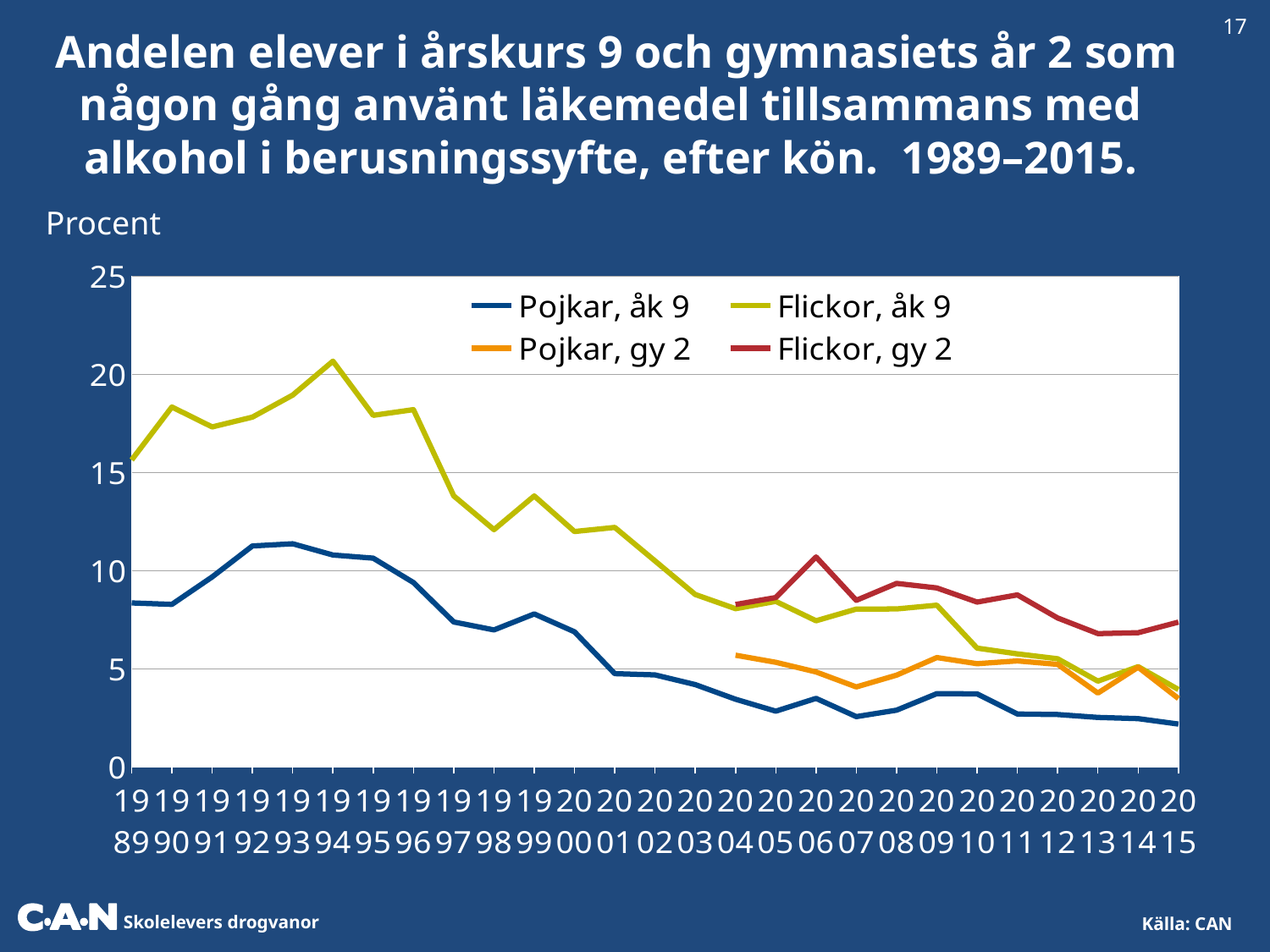
Which series has the highest value in 2015? Flickor, gy 2 Is the value for Pojkar, åk 9 in 2015 greater or less than 5? less Which series has the lowest value in 2015? Pojkar, åk 9 Is the value for Flickor, gy 2 in 2006 greater or less than 10? greater Does the Flickor, åk 9 series generally rise or fall from 1989 to 2015? Fall How many series does the legend list? 4 In which year does the Flickor, åk 9 series reach its highest value? 1994 What kind of chart is shown on the slide? Line chart Is the value for Flickor, åk 9 in 1994 greater or less than 15? greater What unit label is shown above the y axis? Procent In 2006, which is higher: Flickor, gy 2 or Flickor, åk 9? Flickor, gy 2 How many years are plotted along the x axis? 27